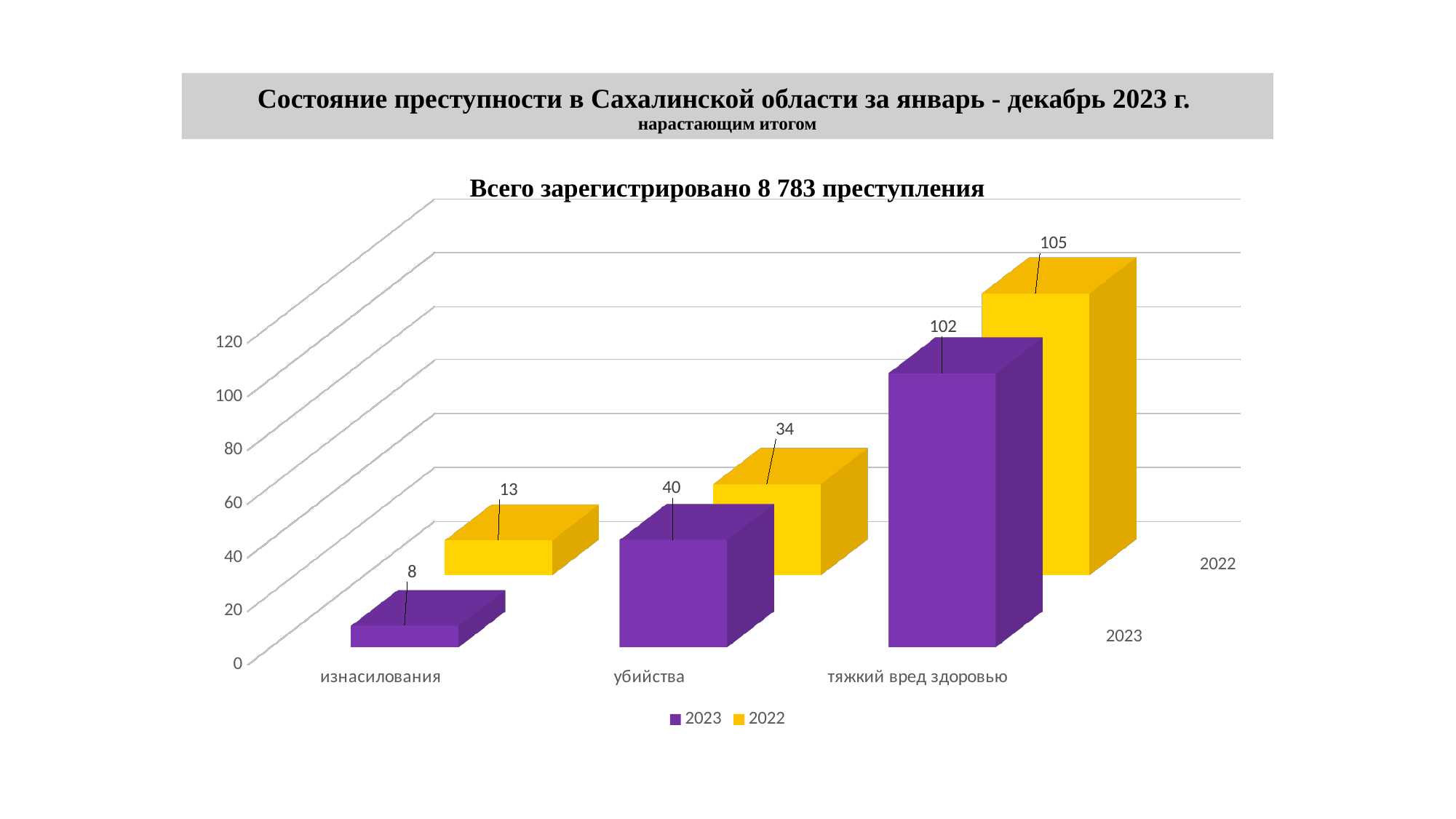
Which is larger for изнасилования: the 2023 value or the 2022 value? 2022 Which category has the highest value in the 2022 series? тяжкий вред здоровью What is the value for изнасилования in the 2023 series? 8 How many series does the legend list? 2 What is the difference between the 2022 and 2023 values for тяжкий вред здоровью? 3 What is the chart's title? Всего зарегистрировано 8 783 преступления How many categories are shown on the x axis? 3 What is the difference between the 2023 and 2022 values for убийства? 6 What is the value for тяжкий вред здоровью in the 2023 series? 102 Which category has the lowest value in the 2023 series? изнасилования What is the value for убийства in the 2022 series? 34 What kind of chart is shown on the slide? bar chart